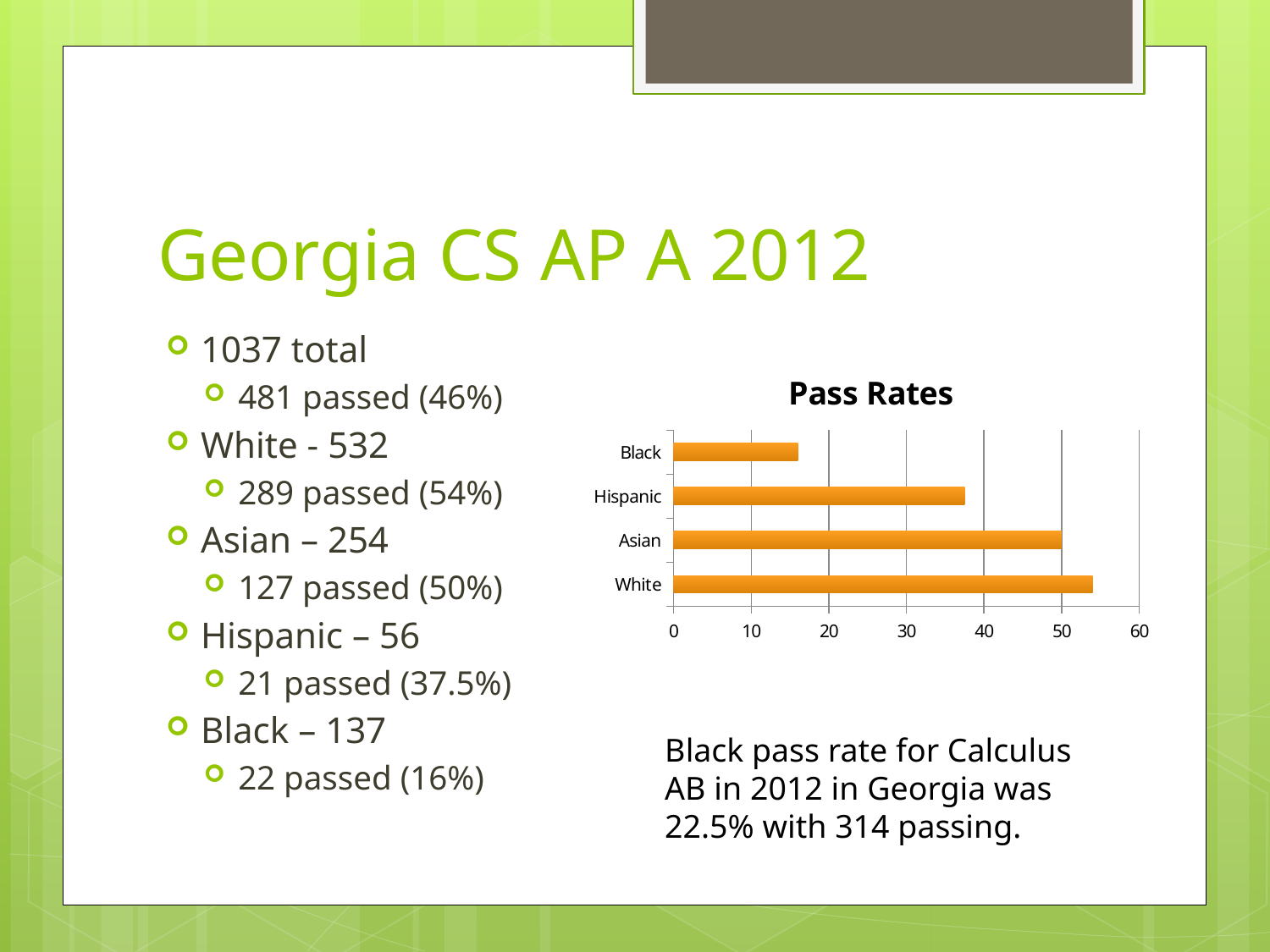
How many categories are shown in the "Pass Rates" chart? 4 What is the value for Asian in the "Pass Rates" chart? 50 In the "Pass Rates" chart, which is larger, the value for Black or the value for White? White In the "Pass Rates" chart, is the value for Black greater or less than 20? less In the "Pass Rates" chart, is the value for Hispanic greater or less than 30? greater In the "Pass Rates" chart, is the value for White greater or less than 50? greater Which category has the lowest pass rate in the "Pass Rates" chart? Black What kind of chart is the "Pass Rates" chart? bar chart In the "Pass Rates" chart, which is larger, the value for Asian or the value for Hispanic? Asian What is the title of the chart on the slide? Pass Rates What colour are the bars in the "Pass Rates" chart? orange Which category has the highest pass rate in the "Pass Rates" chart? White